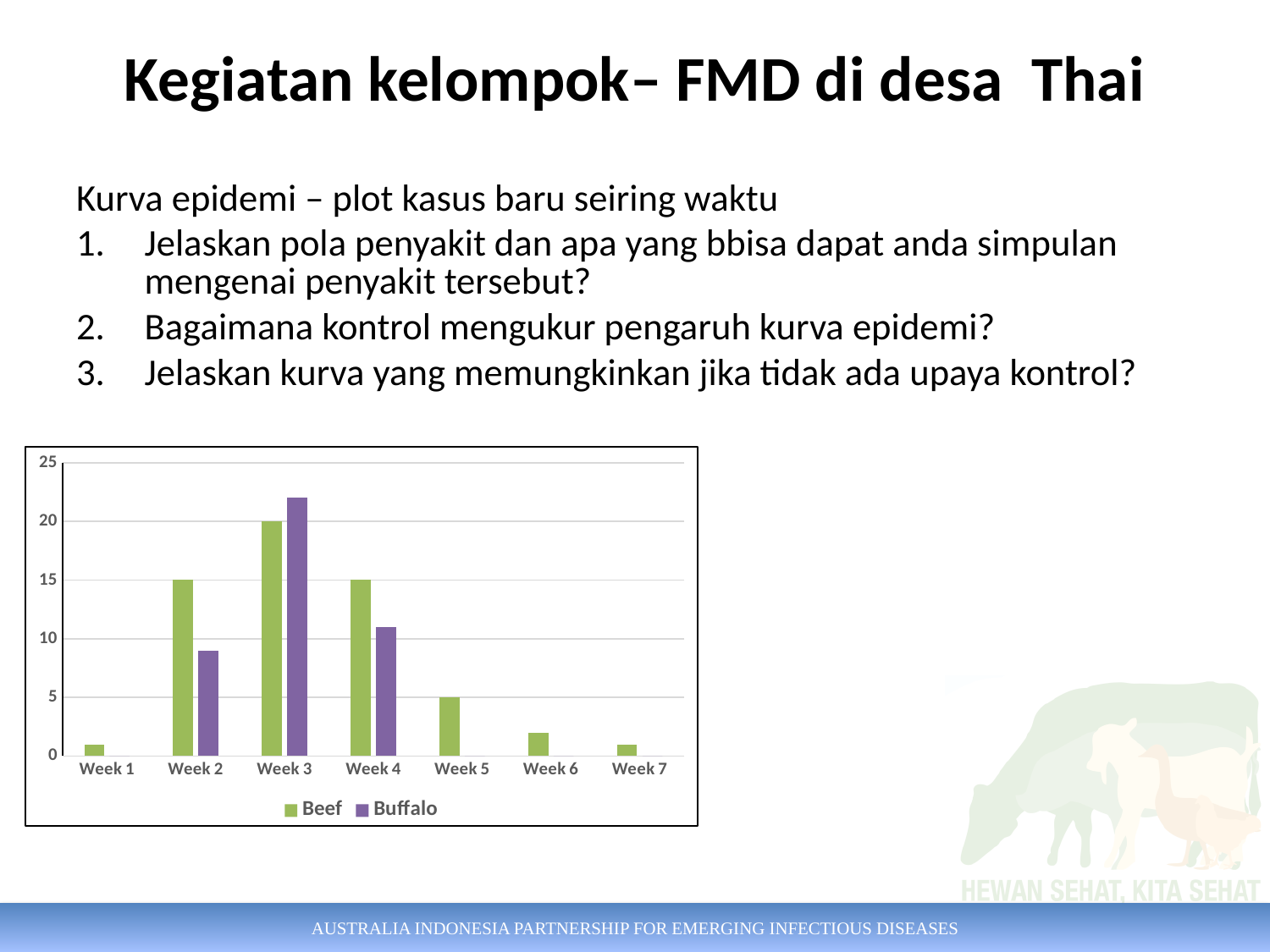
In which week is the Beef series highest? Week 3 What is the Beef value for Week 3? 20 Is the Buffalo value for Week 2 greater or less than 10? less What type of chart is shown on the slide? bar chart In which week is the Buffalo series highest? Week 3 How many series does the chart legend list? 2 In Week 2, which series has the larger value, Beef or Buffalo? Beef What is the Beef value for Week 5? 5 How many weeks are shown on the x axis of the chart? 7 What is the Beef value for Week 2? 15 What is the difference between the Beef values for Week 3 and Week 2? 5 Is the Buffalo value for Week 3 greater or less than 20? greater